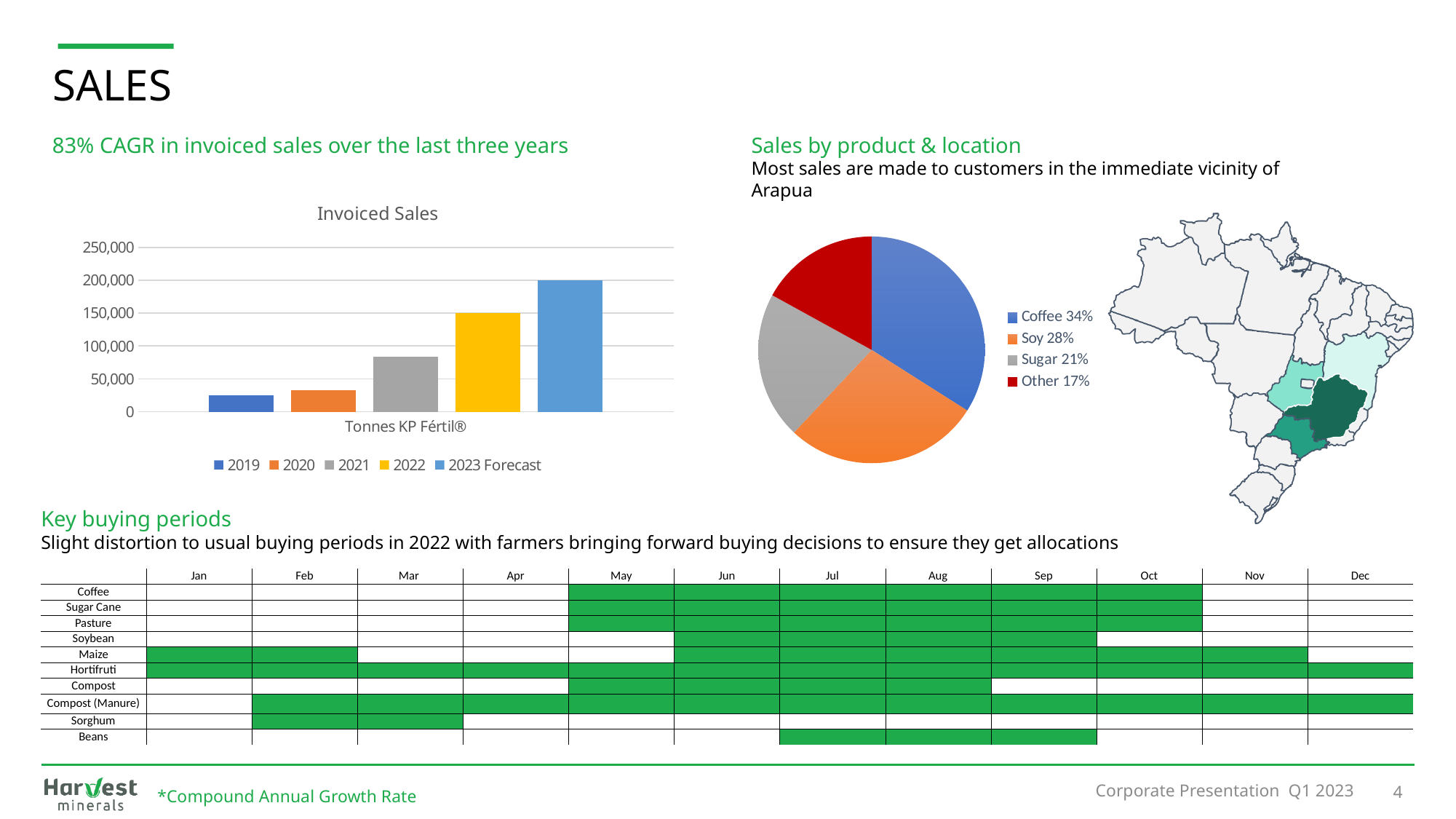
In the pie chart, which is larger, Soy or Sugar? Soy In the Invoiced Sales chart, which year has the highest bar? 2023 Forecast In the Invoiced Sales chart, which year has the lowest bar? 2019 In the Invoiced Sales chart, is the value for 2021 greater or less than 100,000? less In the pie chart, which product has the largest share of sales? Coffee How many series does the legend of the Invoiced Sales chart list? 5 In the pie chart, what is the difference in percentage points between Coffee and Soy? 6 What kind of chart is the Invoiced Sales chart? bar chart In the pie chart, which category has the smallest share? Other In the pie chart, what share of sales is Coffee? 34% How many slices does the pie chart have? 4 In the Invoiced Sales chart, do the values rise or fall from 2019 to 2023 Forecast? rise